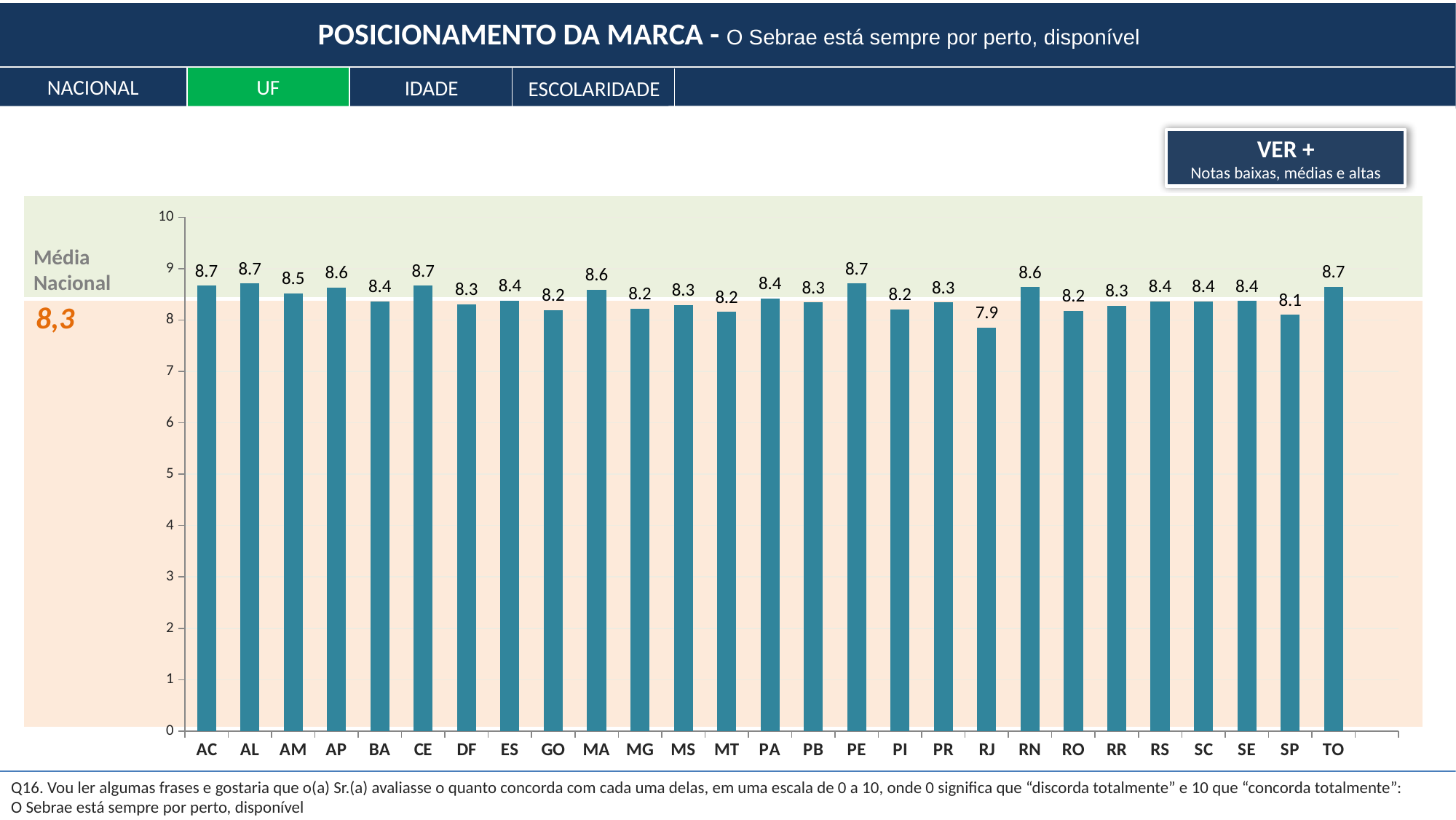
What is the value for RJ? 7.9 What is the difference between the values for AC and RJ? 0.8 What is the difference between the values for TO and SP? 0.6 What is the value for AM? 8.5 What is the value for SP? 8.1 How many states (UF) are shown on the x axis? 27 Which state has the lowest value? RJ Which is larger, the value for RN or the value for RO? RN What kind of chart is shown on the slide? bar chart What is the Média Nacional value shown on the left of the chart? 8,3 What is the value for MA? 8.6 Which is larger, the value for PE or the value for PI? PE